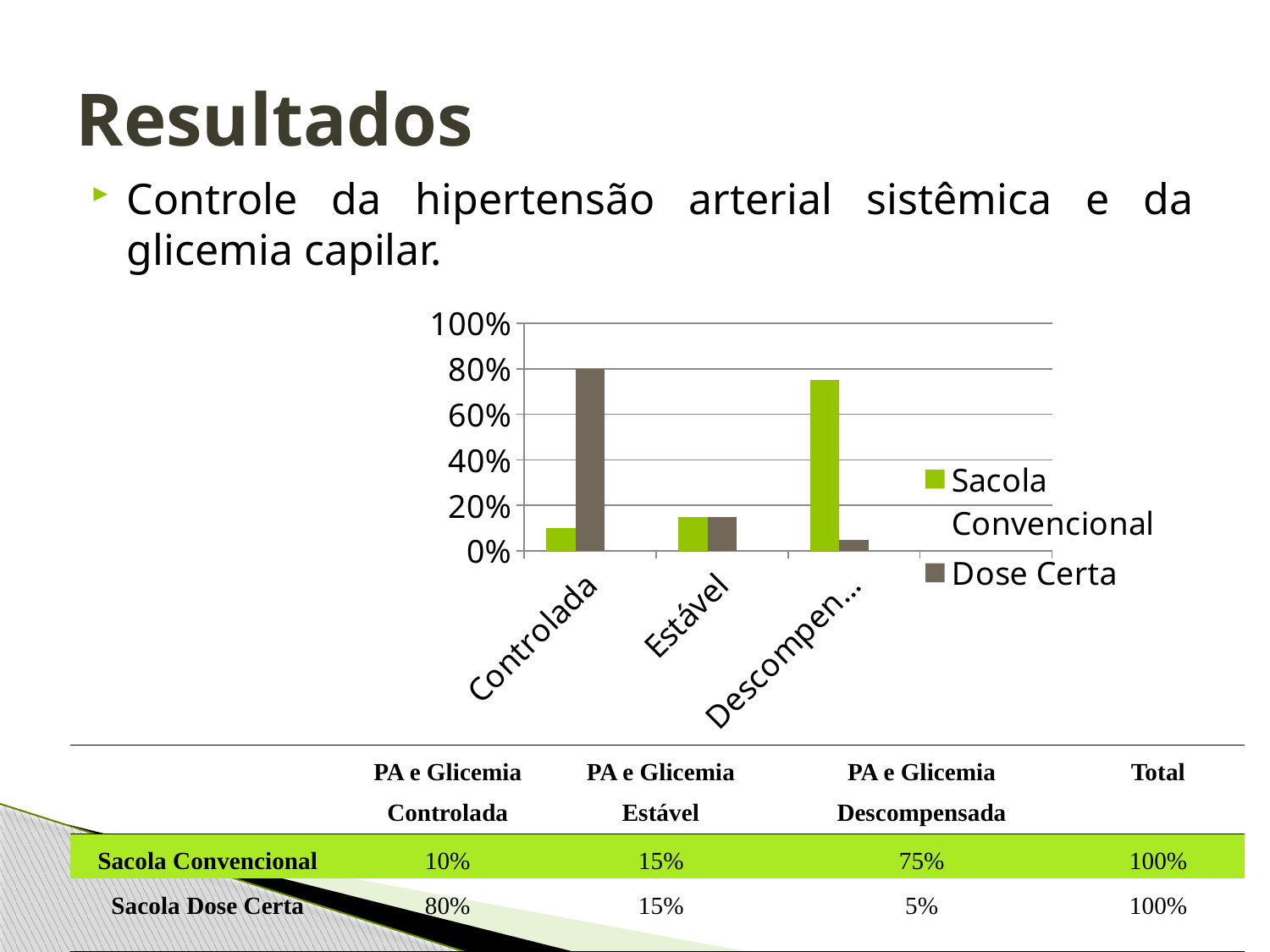
What kind of chart is shown on the slide? bar chart How many categories are shown on the x axis of the chart? 3 Which series is shown in green in the chart? Sacola Convencional How many series does the chart legend list? 2 What is the value for Dose Certa in the Descompensada category? 5% In which category does the Dose Certa series reach its highest value? Controlada What is the difference between Dose Certa and Sacola Convencional in the Controlada category? 70% In which category does the Sacola Convencional series have its lowest value? Controlada What is the value for Dose Certa in the Controlada category? 80% What is the value for Sacola Convencional in the Controlada category? 10% Which series has the larger value in the Descompensada category? Sacola Convencional What is the value for Sacola Convencional in the Descompensada category? 75%